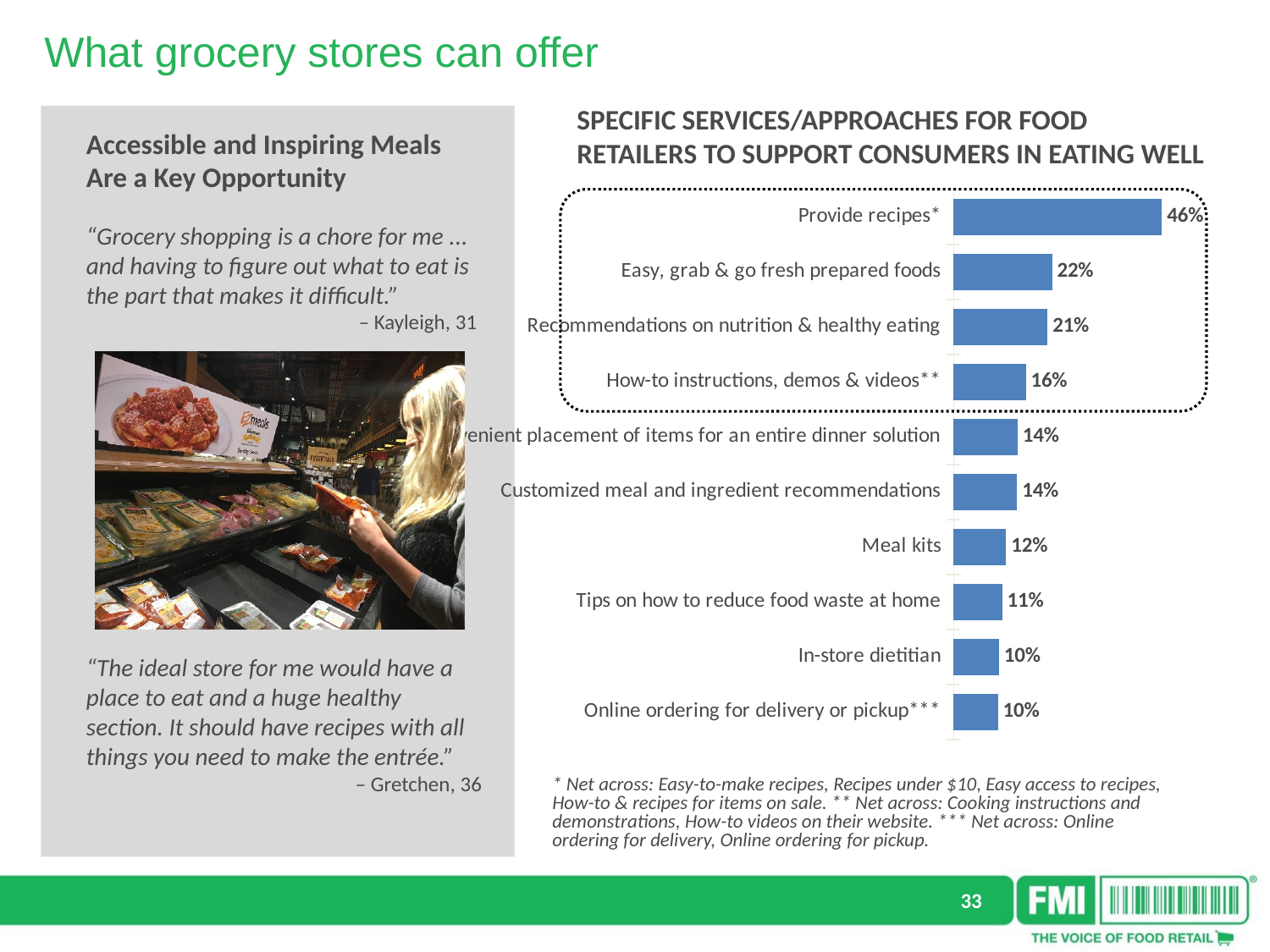
What percentage is shown for "Meal kits"? 12% What percentage is shown for "In-store dietitian"? 10% What is the difference between the values for "Provide recipes" and "Easy, grab & go fresh prepared foods"? 24% What percentage is shown for "Provide recipes"? 46% Which category has the highest value in the chart? Provide recipes What kind of chart is shown on the slide? Bar chart What percentage is shown for "Tips on how to reduce food waste at home"? 11% What is the difference between the values for "Customized meal and ingredient recommendations" and "Online ordering for delivery or pickup"? 4% Which is larger: the value for "Recommendations on nutrition & healthy eating" or the value for "How-to instructions, demos & videos"? Recommendations on nutrition & healthy eating How many categories are shown in the chart? 10 What percentage is shown for "Easy, grab & go fresh prepared foods"? 22% What is the title of the chart? Specific services/approaches for food retailers to support consumers in eating well